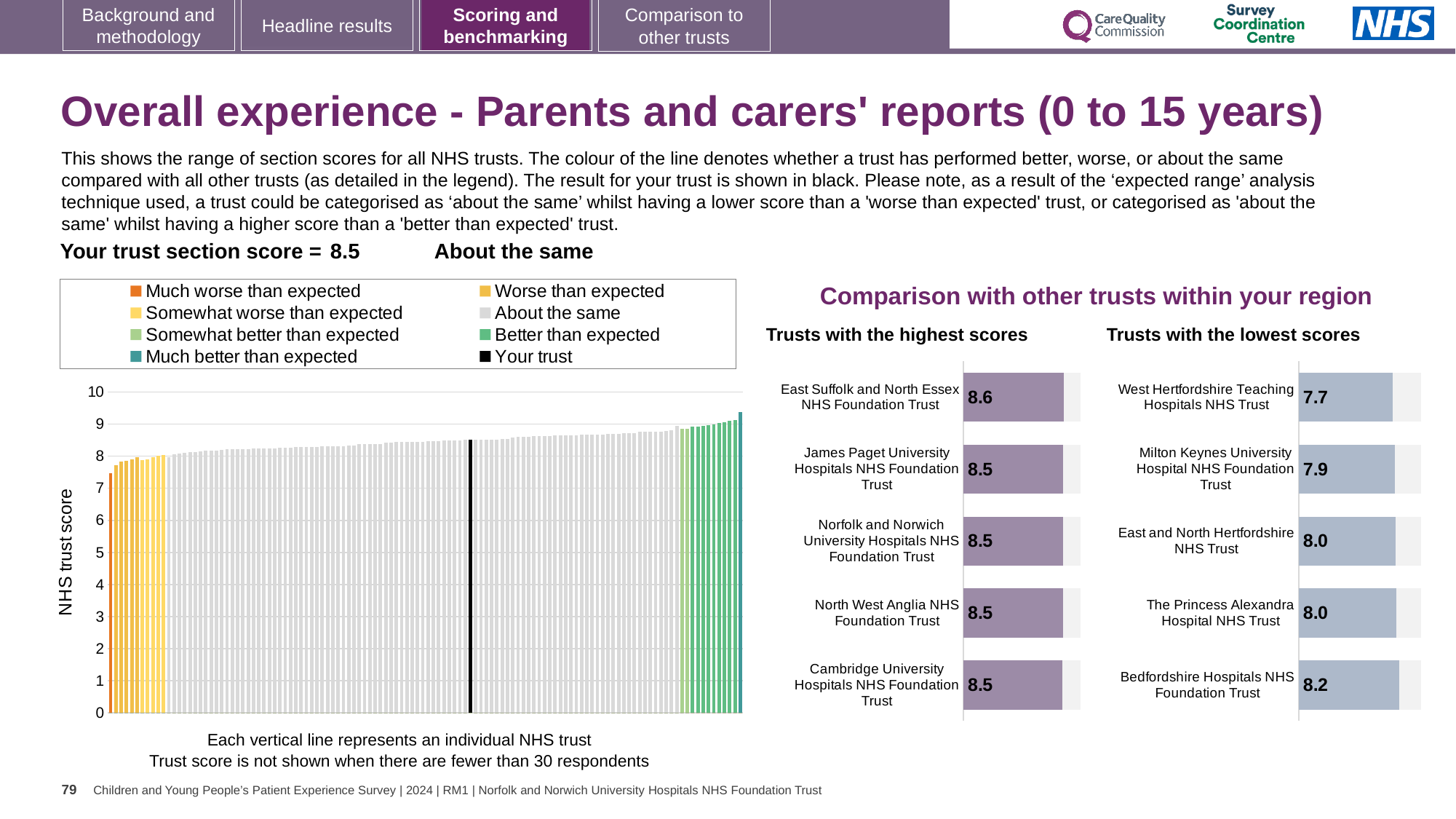
In the 'Trusts with the lowest scores' chart, which trust has the lowest score? West Hertfordshire Teaching Hospitals NHS Trust In the 'Trusts with the lowest scores' chart, which trust has the highest score? Bedfordshire Hospitals NHS Foundation Trust In the main NHS trust score chart on the left, do the bar values rise or fall from left to right? rise How many entries does the legend above the main NHS trust score chart list? 8 In the 'Trusts with the lowest scores' chart, what is the difference between the scores of Bedfordshire Hospitals NHS Foundation Trust and West Hertfordshire Teaching Hospitals NHS Trust? 0.5 In the 'Trusts with the lowest scores' chart, is the score for The Princess Alexandra Hospital NHS Trust larger or smaller than the score for West Hertfordshire Teaching Hospitals NHS Trust? larger In the 'Trusts with the lowest scores' chart, what is the score for Milton Keynes University Hospital NHS Foundation Trust? 7.9 In the main NHS trust score chart on the left, what is the section score for your trust (the black bar)? 8.5 In the 'Trusts with the highest scores' chart, what is the score for East Suffolk and North Essex NHS Foundation Trust? 8.6 In the 'Trusts with the highest scores' chart, how many trusts are listed? 5 In the main NHS trust score chart on the left, is the value of the leftmost (orange) bar greater or less than 8? less In the 'Trusts with the highest scores' chart, which trust has the highest score? East Suffolk and North Essex NHS Foundation Trust